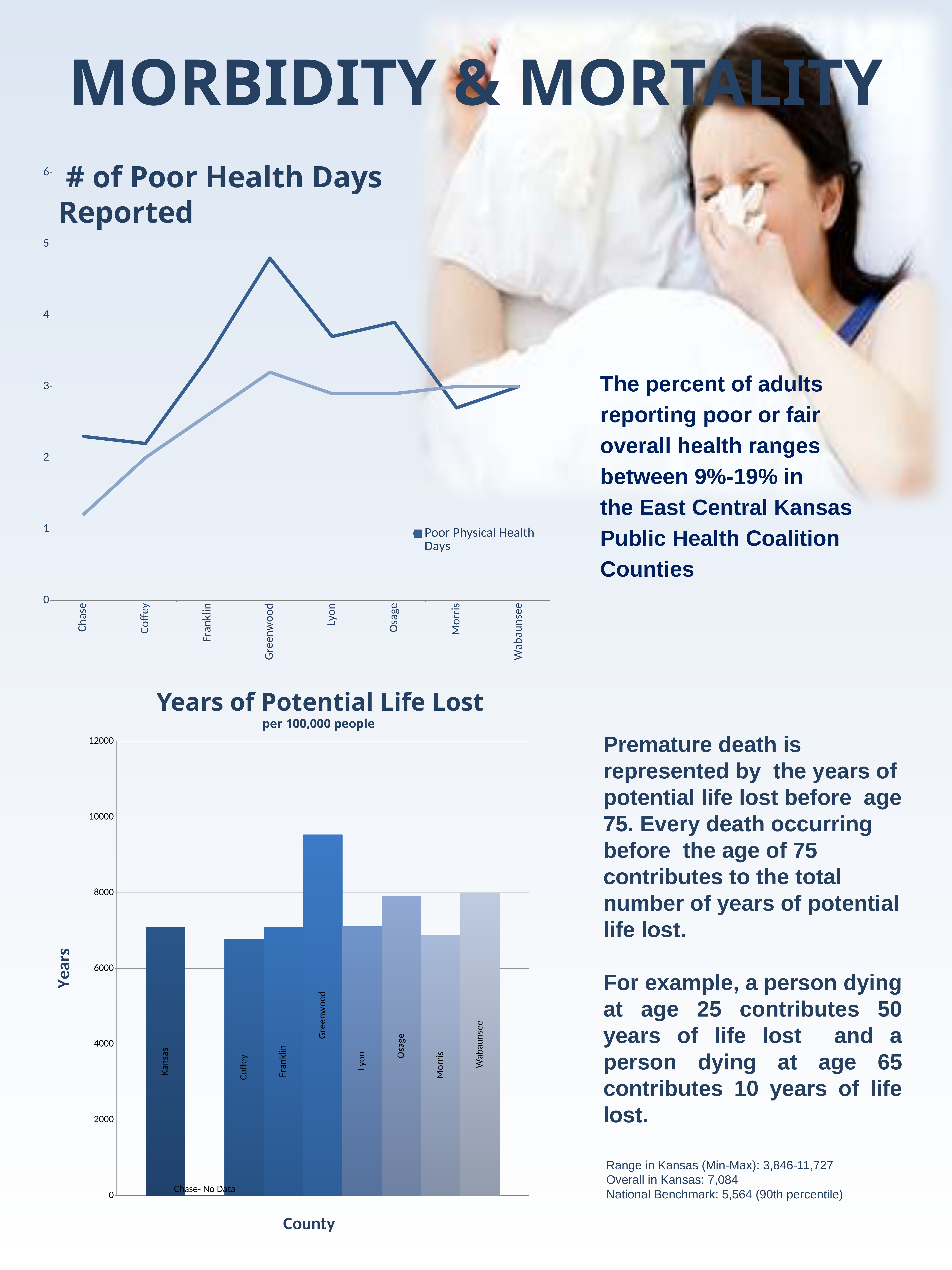
How many counties are listed on the x axis of the "# of Poor Health Days Reported" chart? 8 In the "Years of Potential Life Lost" chart, which is larger, Wabaunsee or Morris? Wabaunsee In the "Years of Potential Life Lost" chart, is the value for Coffey greater or less than 8000? less What kind of chart is the "# of Poor Health Days Reported" chart? line chart In the "# of Poor Health Days Reported" chart, at which county does the Poor Physical Health Days line reach its highest point? Greenwood In the "Years of Potential Life Lost" chart, which county is marked as having no data? Chase In the "# of Poor Health Days Reported" chart, is the Poor Physical Health Days value for Greenwood greater or less than 4? greater In the "Years of Potential Life Lost" chart, which county has the highest value? Greenwood In the "Years of Potential Life Lost" chart, which is larger, Greenwood or Coffey? Greenwood What kind of chart is the "Years of Potential Life Lost" chart? bar chart In the "Years of Potential Life Lost" chart, is the value for Greenwood greater or less than 8000? greater